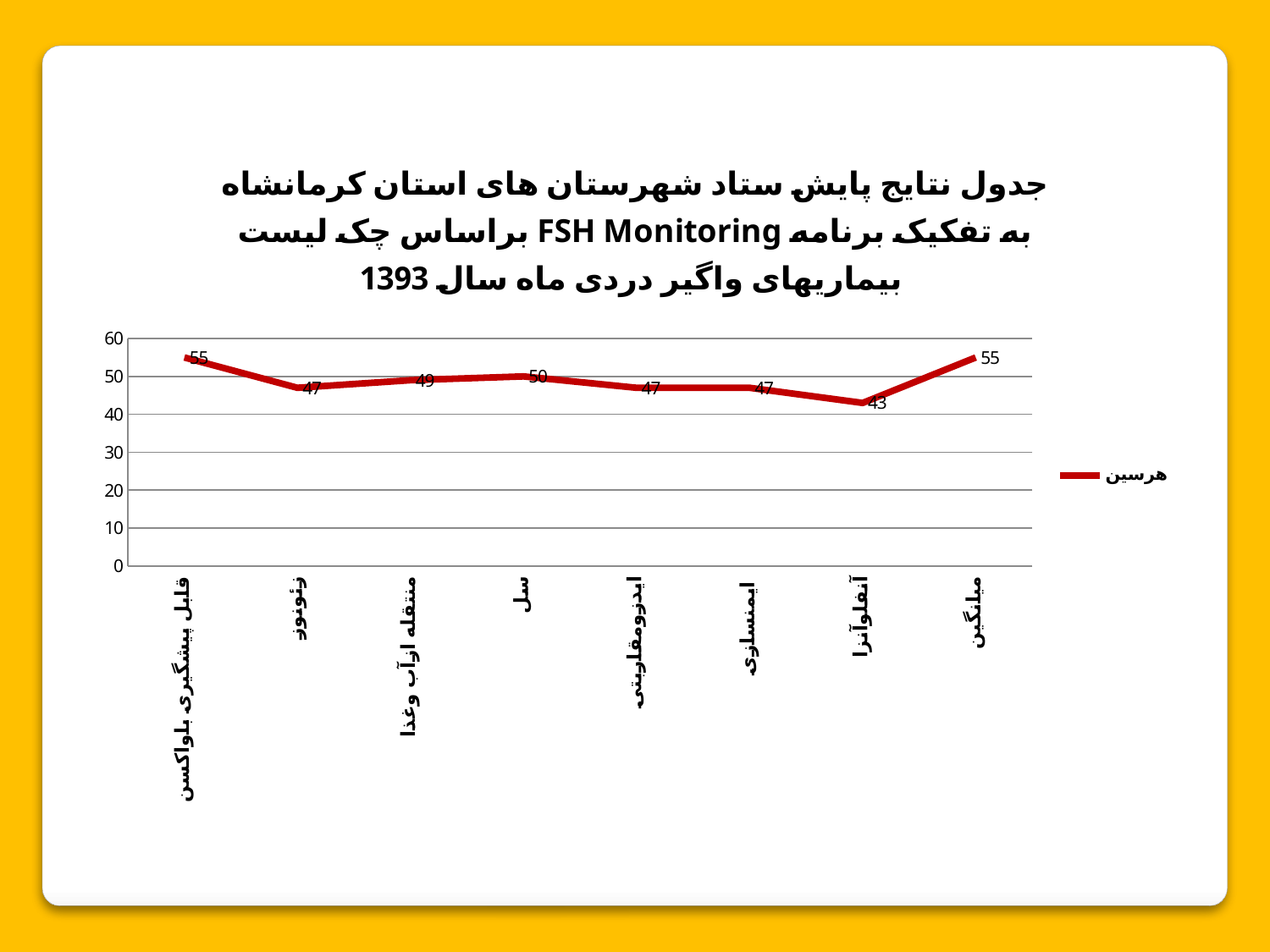
Is the value for آنفلوآنزا greater or less than 50? less What is the value for منتقله از آب و غذا? 49 How many categories are plotted on the x axis? 8 How many series does the legend list? 1 What is the difference between the values for سل and آنفلوآنزا? 7 What is the value for میانگین? 55 What type of chart is shown on the slide? line chart Which is larger, the value for زئونوز or the value for سل? سل What is the value for آنفلوآنزا? 43 What is the value for سل? 50 Which category has the lowest value? آنفلوآنزا What is the name of the series shown in the legend? هرسین